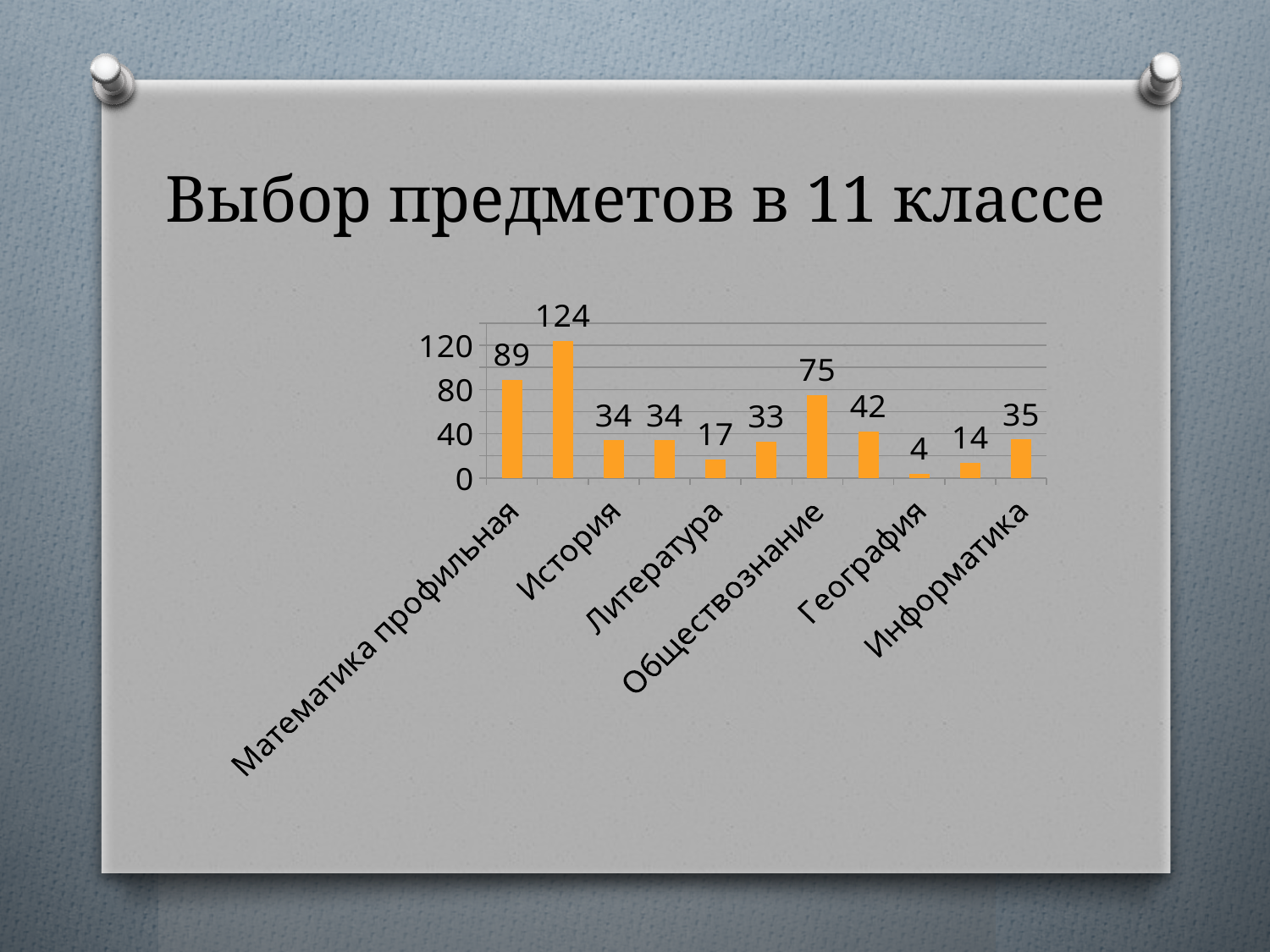
What is the value for Обществознание? 75 What is the difference between the values for Математика профильная and Обществознание? 14 What is the value for Математика профильная? 89 What is the title of the chart? Выбор предметов в 11 классе How many bars are plotted in the chart? 11 Which is larger, the value for Обществознание or the value for Литература? Обществознание What is the value for Литература? 17 Which category has the lowest value? География What is the value for Информатика? 35 What kind of chart is shown on the slide? bar chart What is the highest value shown in the chart? 124 What is the value for География? 4